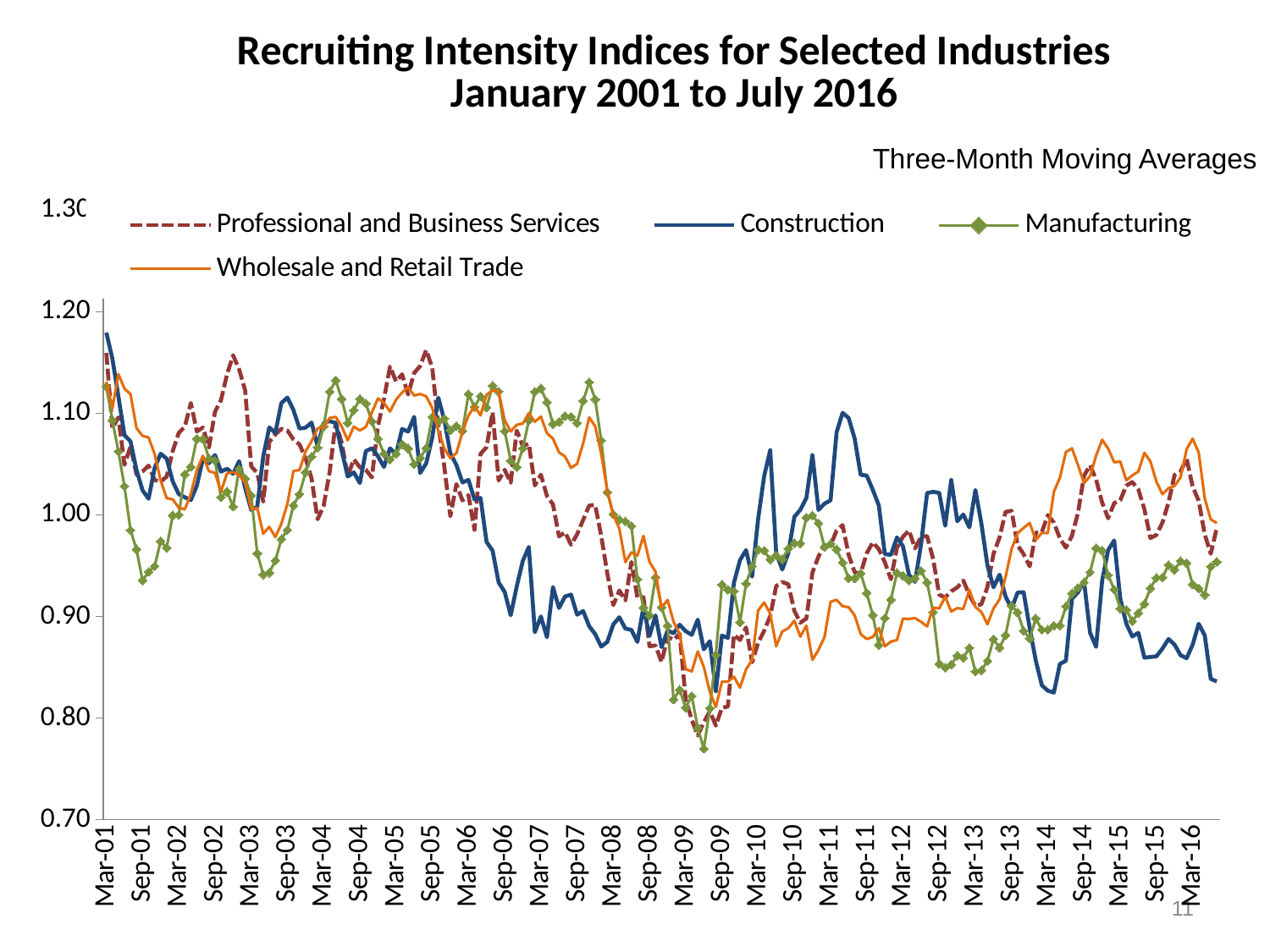
Is the value for Manufacturing at Sep-01 greater or less than 1.00? less Is the value for Construction at Mar-14 greater or less than 0.90? less Does the Construction line rise or fall between Sep-05 and Mar-09? fall Which series is drawn with a dashed line? Professional and Business Services Which series has the highest value at Mar-01? Construction At Mar-14, which is higher: Wholesale and Retail Trade or Construction? Wholesale and Retail Trade What is the title of the chart? Recruiting Intensity Indices for Selected Industries January 2001 to July 2016 Which series has the lowest value at Mar-14? Construction Is the value for Construction at Mar-01 greater or less than 1.10? greater What kind of chart is shown on the slide? Line chart How many series does the legend list? 4